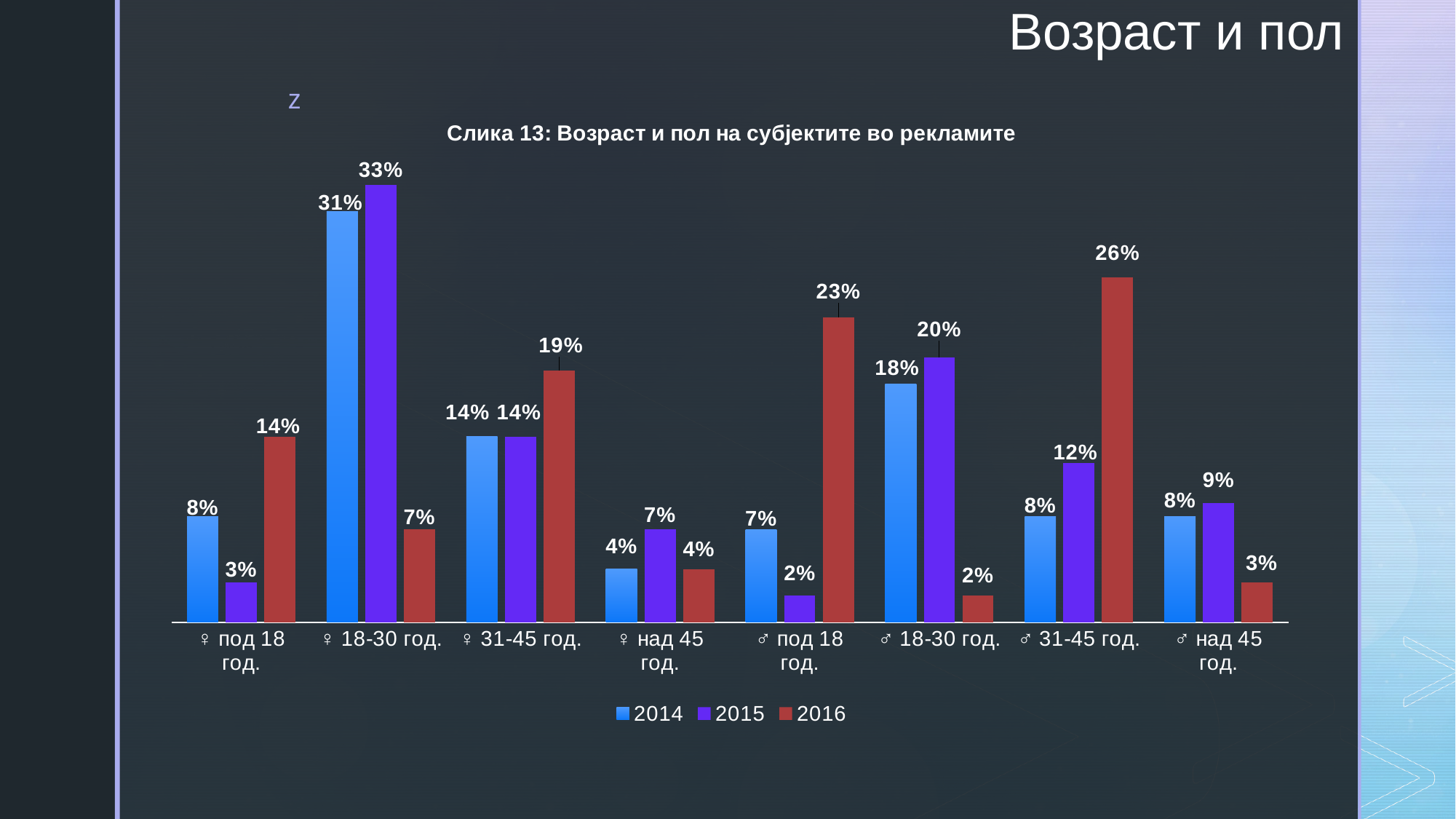
How many categories are shown on the x axis? 8 Which is larger for ♀ под 18 год.: the 2014 value or the 2016 value? 2016 How many series does the legend list? 3 Which category has the lowest 2015 value? ♂ под 18 год. Which colour represents the 2016 series in the legend? Red What kind of chart is shown on the slide? Bar chart What is the 2015 value for ♀ 18-30 год.? 33% What is the difference between the 2016 and 2014 values for ♂ 31-45 год.? 18% What is the 2014 value for ♂ 18-30 год.? 18% What is the title of the chart? Слика 13: Возраст и пол на субјектите во рекламите What is the 2016 value for ♂ под 18 год.? 23% Which category has the highest 2016 value? ♂ 31-45 год.